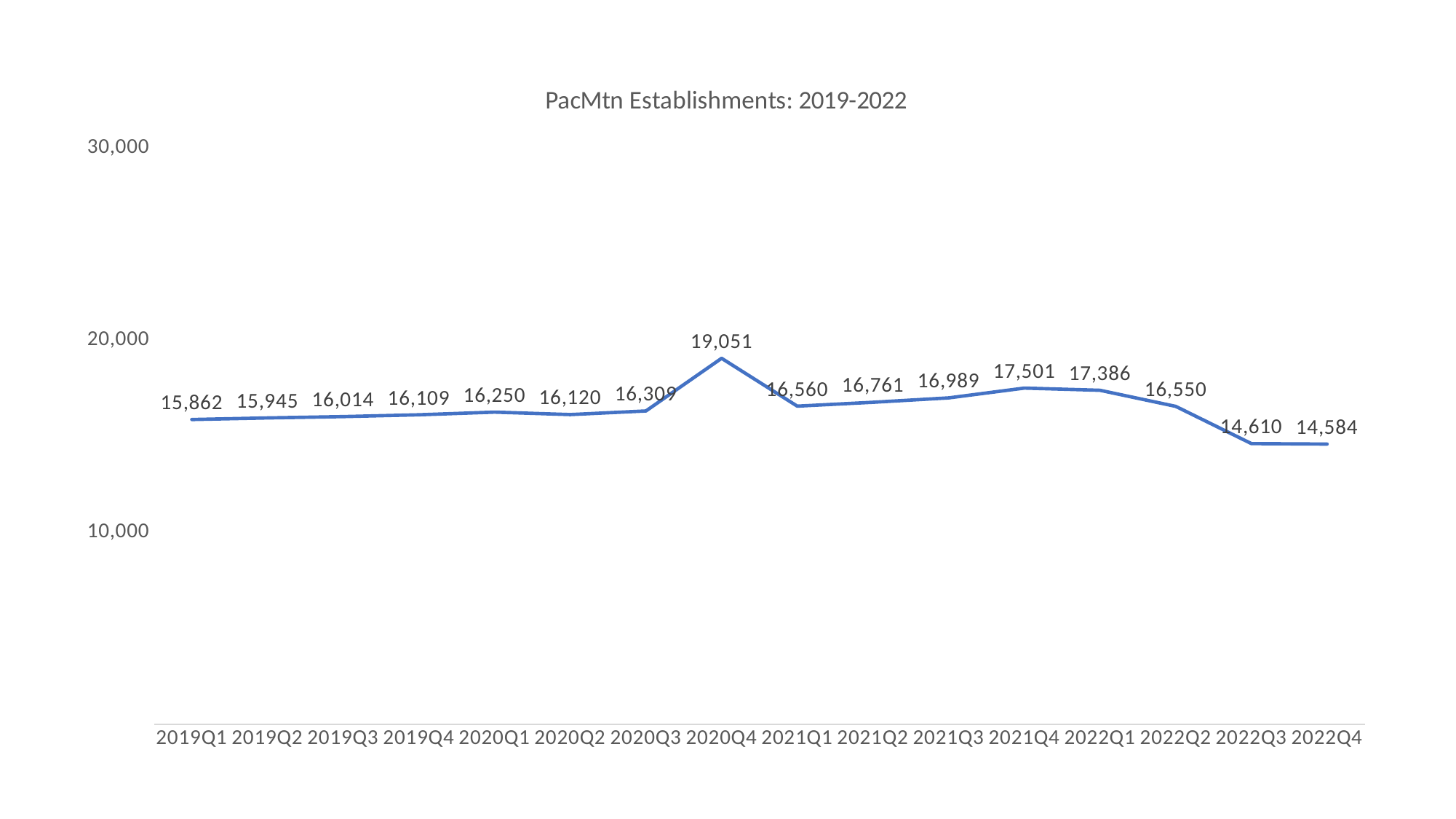
What is the value for 2020Q4? 19,051 What is the title of the chart? PacMtn Establishments: 2019-2022 What is the value for 2022Q4? 14,584 What kind of chart is this? line chart Which quarter has the highest value? 2020Q4 What is the value for 2019Q1? 15,862 How many quarters are plotted on the x axis? 16 Which is larger, the value for 2021Q4 or the value for 2022Q2? 2021Q4 Is the value for 2022Q3 greater or less than 20,000? less Do the values rise or fall from 2022Q1 to 2022Q4? fall What is the difference between the values for 2020Q4 and 2021Q1? 2,491 Which quarter has the lowest value? 2022Q4